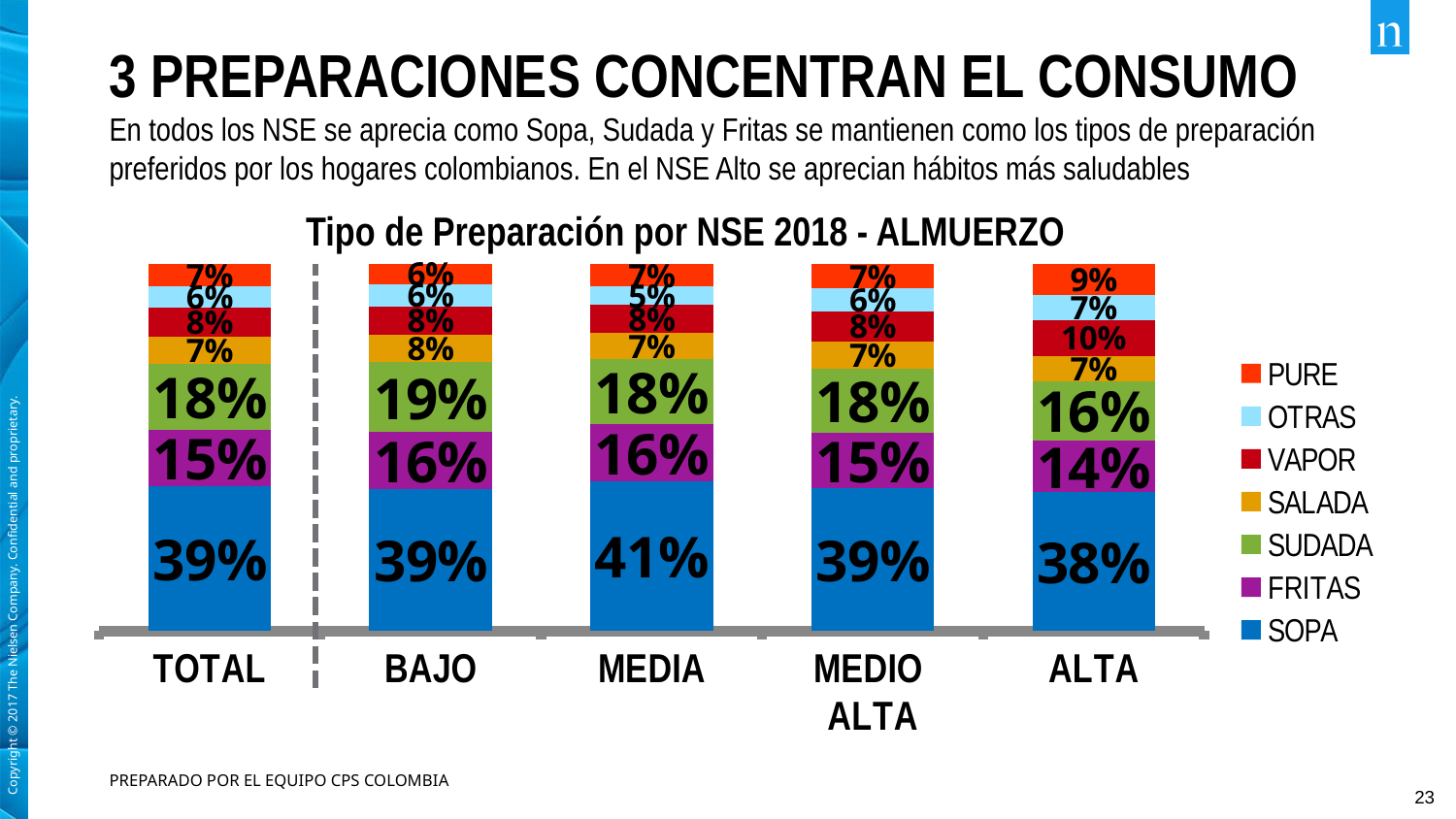
Which NSE category has the highest SOPA value? MEDIA Is the FRITAS value larger for BAJO or for ALTA? BAJO What is the SOPA value for MEDIA? 41% What is the SUDADA value for BAJO? 19% What is the PURE value for ALTA? 9% What is the difference between the SOPA value for MEDIA and the SOPA value for ALTA? 3% Which NSE category has the lowest SUDADA value? ALTA How many series does the legend list? 7 What is the SOPA value for ALTA? 38% What kind of chart is shown on the slide? Stacked bar chart What is the VAPOR value for ALTA? 10% What is the FRITAS value for ALTA? 14%